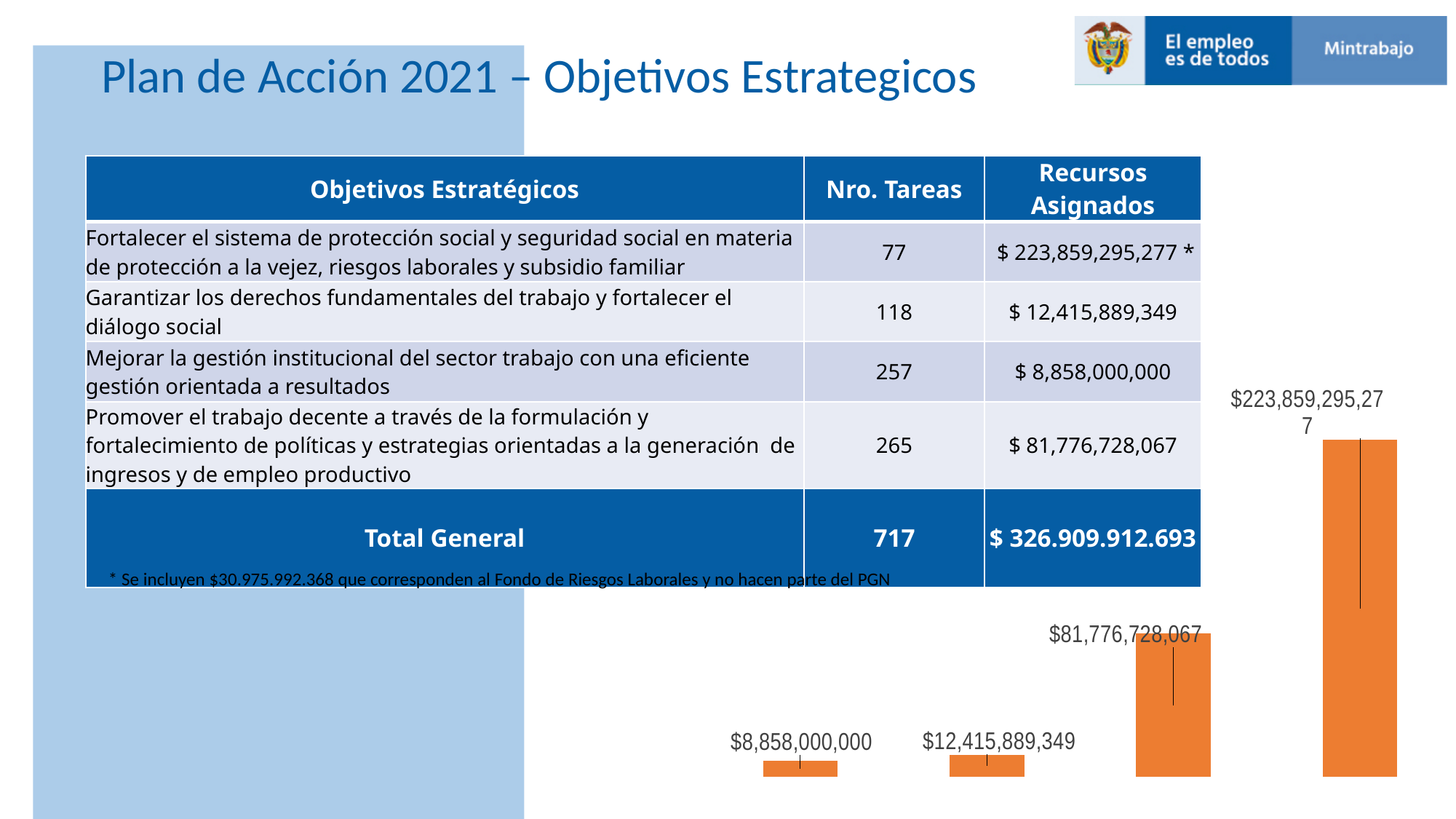
Which is larger in the chart: the second bar from the left or the third bar from the left? the third bar ($81,776,728,067) What value is labelled on the third bar from the left in the chart? $81,776,728,067 Do the bar values rise or fall from left to right across the chart? rise What value is labelled on the second bar from the left in the chart? $12,415,889,349 What is the difference between the tallest and the shortest bar in the chart? $215,001,295,277 What is the highest value labelled on the bar chart? $223,859,295,277 How many bars does the chart at the bottom right of the slide have? 4 What kind of chart is shown at the bottom right of the slide? bar chart What is the difference between the third bar ($81,776,728,067) and the second bar ($12,415,889,349) in the chart? $69,360,838,718 What value is labelled on the leftmost bar of the chart? $8,858,000,000 What is the lowest value labelled on the bar chart? $8,858,000,000 What value is labelled on the rightmost bar of the chart? $223,859,295,277